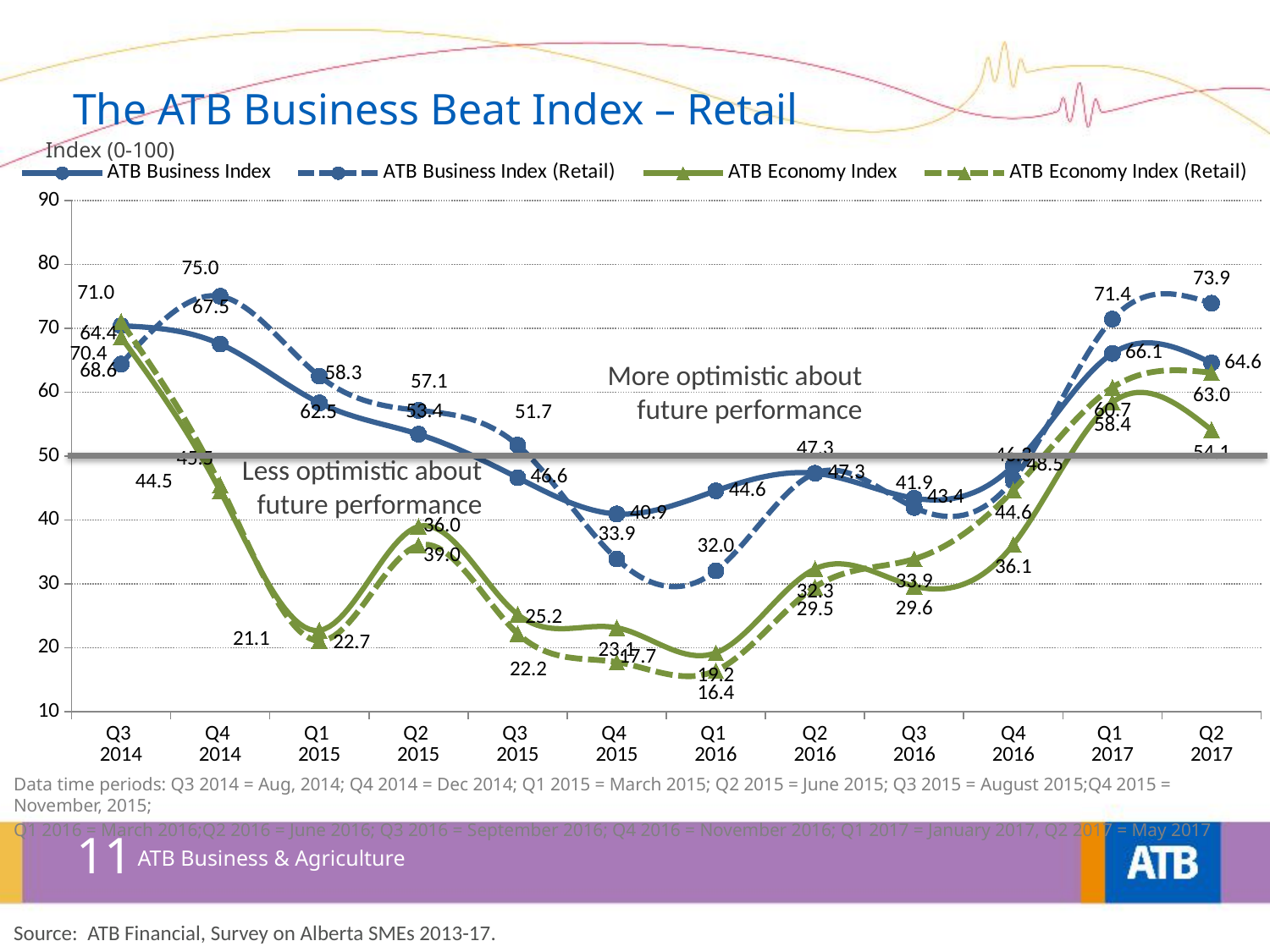
In Q1 2016, which is larger: the ATB Business Index or the ATB Business Index (Retail)? ATB Business Index What is the value of the ATB Business Index in Q2 2017? 64.6 What is the title of the chart? The ATB Business Beat Index – Retail What is the highest value of the ATB Business Index (Retail)? 75.0 In which quarter does the ATB Business Index (Retail) reach its highest value? Q4 2014 What is the difference between the ATB Business Index (Retail) and the ATB Business Index in Q2 2017? 9.3 What kind of chart is shown on the slide? Line chart What is the value of the ATB Business Index (Retail) in Q1 2016? 32.0 What is the value of the ATB Business Index (Retail) in Q2 2017? 73.9 How many quarters are plotted along the x axis? 12 How many series does the legend list? 4 Is the value of the ATB Economy Index in Q4 2014 greater or less than 50? less